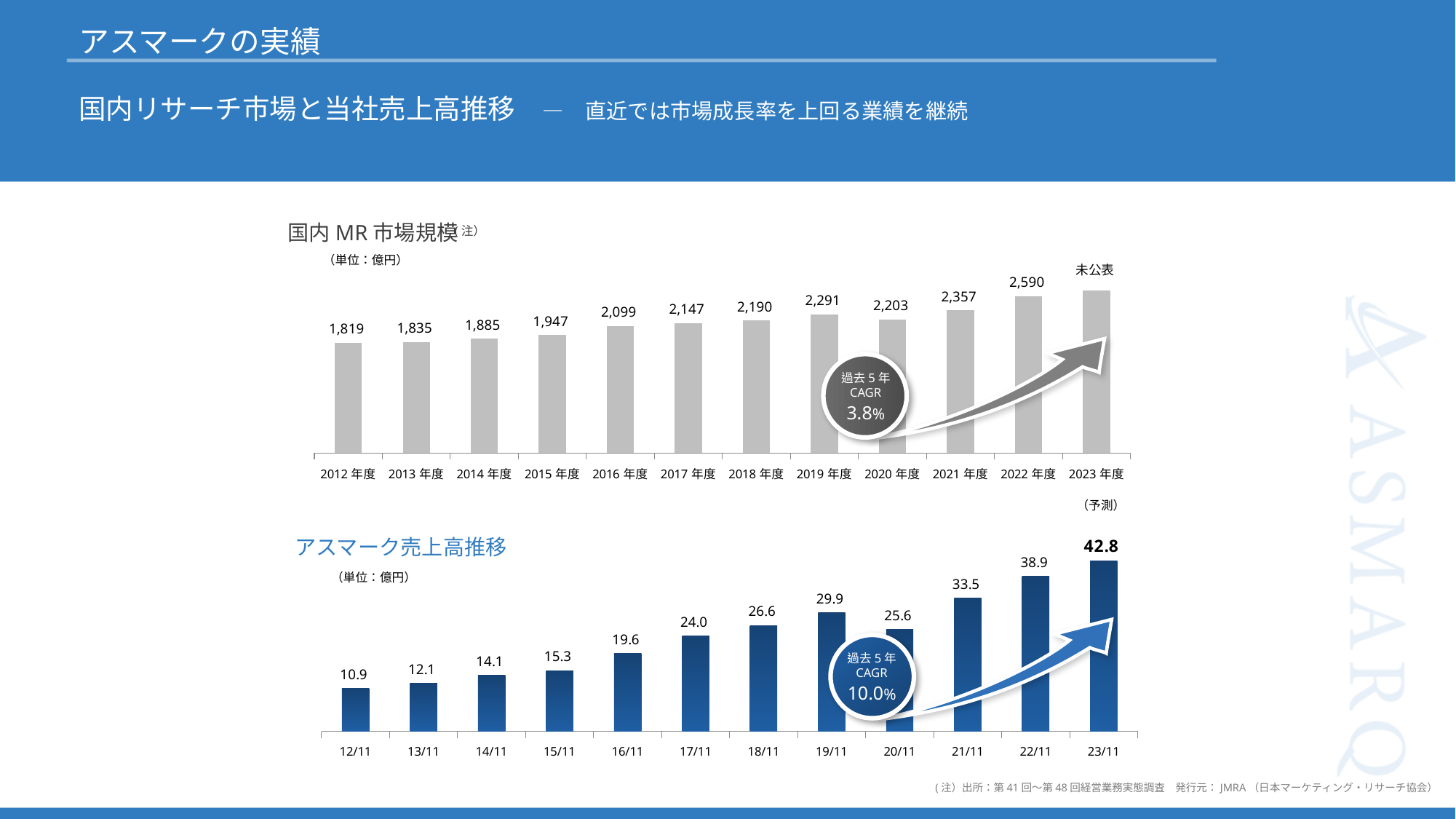
In the アスマーク売上高推移 chart (bottom), what is the value for 23/11? 42.8 In the アスマーク売上高推移 chart (bottom), which is larger, the value for 19/11 or the value for 20/11? 19/11 In the 国内MR市場規模 chart (top), what is the value for 2019年度? 2,291 In the アスマーク売上高推移 chart (bottom), which period has the lowest value? 12/11 In the 国内MR市場規模 chart (top), what label is shown above the 2023年度 bar instead of a value? 未公表 In the アスマーク売上高推移 chart (bottom), what is the value for 20/11? 25.6 What kind of chart is the アスマーク売上高推移 chart (bottom)? Bar chart In the 国内MR市場規模 chart (top), what is the difference between the 2022年度 and 2021年度 values? 233 In the アスマーク売上高推移 chart (bottom), what is the difference between the 22/11 and 21/11 values? 5.4 In the 国内MR市場規模 chart (top), which fiscal year has the highest labelled value? 2022年度 In the 国内MR市場規模 chart (top), what is the value for 2012年度? 1,819 In the 国内MR市場規模 chart (top), how many fiscal years are shown on the x axis? 12